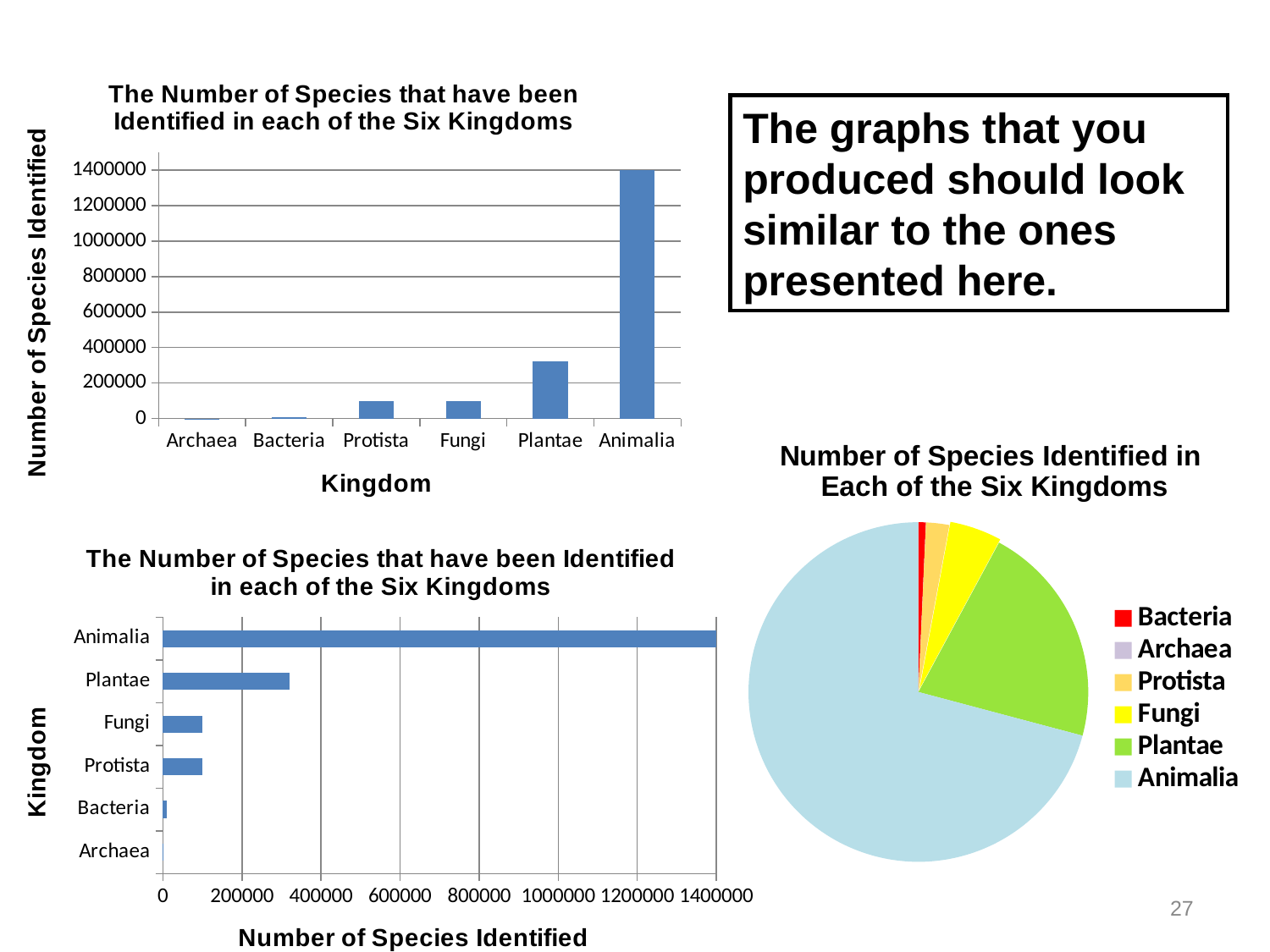
In the top-left bar chart, is the value for Fungi greater or less than 200000? less In the pie chart titled 'Number of Species Identified in Each of the Six Kingdoms', which kingdom has the largest slice? Animalia In the bottom-left bar chart, which kingdom has the longest bar? Animalia In the bottom-left bar chart, which is larger, the value for Bacteria or the value for Protista? Protista How many kingdoms are shown on the x axis of the top-left bar chart? 6 In the top-left chart titled 'The Number of Species that have been Identified in each of the Six Kingdoms', which kingdom has the highest number of species identified? Animalia In the top-left bar chart, what is the value for Animalia? 1400000 What kind of chart is the bottom-left chart? Bar chart In the top-left bar chart, is the value for Plantae greater or less than 200000? greater In the top-left bar chart, which is larger, the value for Plantae or the value for Fungi? Plantae How many entries does the legend of the pie chart list? 6 In the bottom-left bar chart, is the value for Plantae greater or less than 400000? less